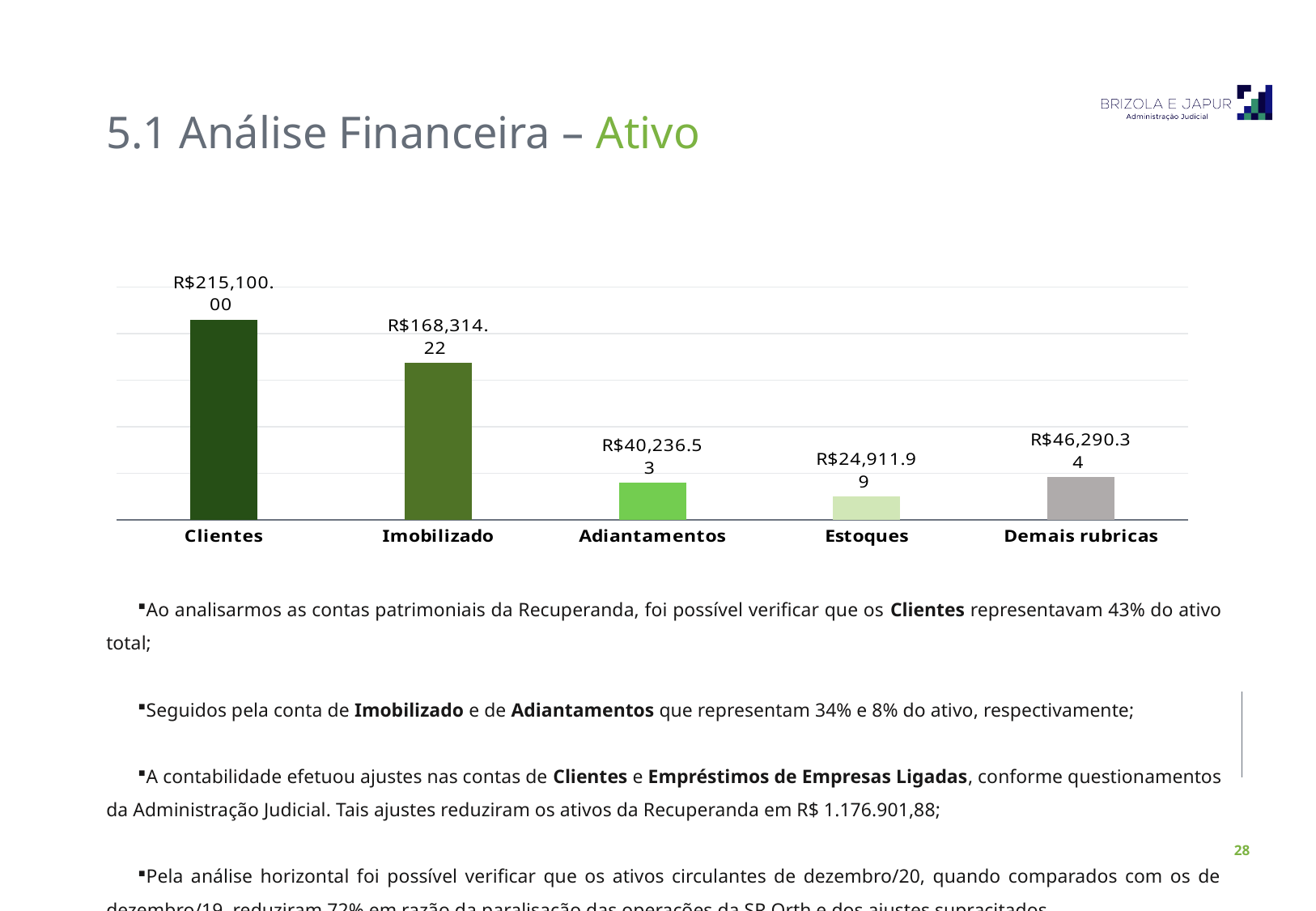
What is the value shown for Clientes in the bar chart? R$215,100.00 What is the value shown for Estoques in the bar chart? R$24,911.99 What is the value shown for Demais rubricas in the bar chart? R$46,290.34 Which category has the lowest value in the bar chart? Estoques How many categories are shown in the bar chart? 5 Which is larger, the value for Demais rubricas or the value for Adiantamentos? Demais rubricas What type of chart is shown on the slide? Bar chart What is the value shown for Adiantamentos in the bar chart? R$40,236.53 Which category has the highest value in the bar chart? Clientes What is the value shown for Imobilizado in the bar chart? R$168,314.22 What is the difference between the values for Clientes and Imobilizado? R$46,785.78 What is the difference between the values for Adiantamentos and Estoques? R$15,324.54